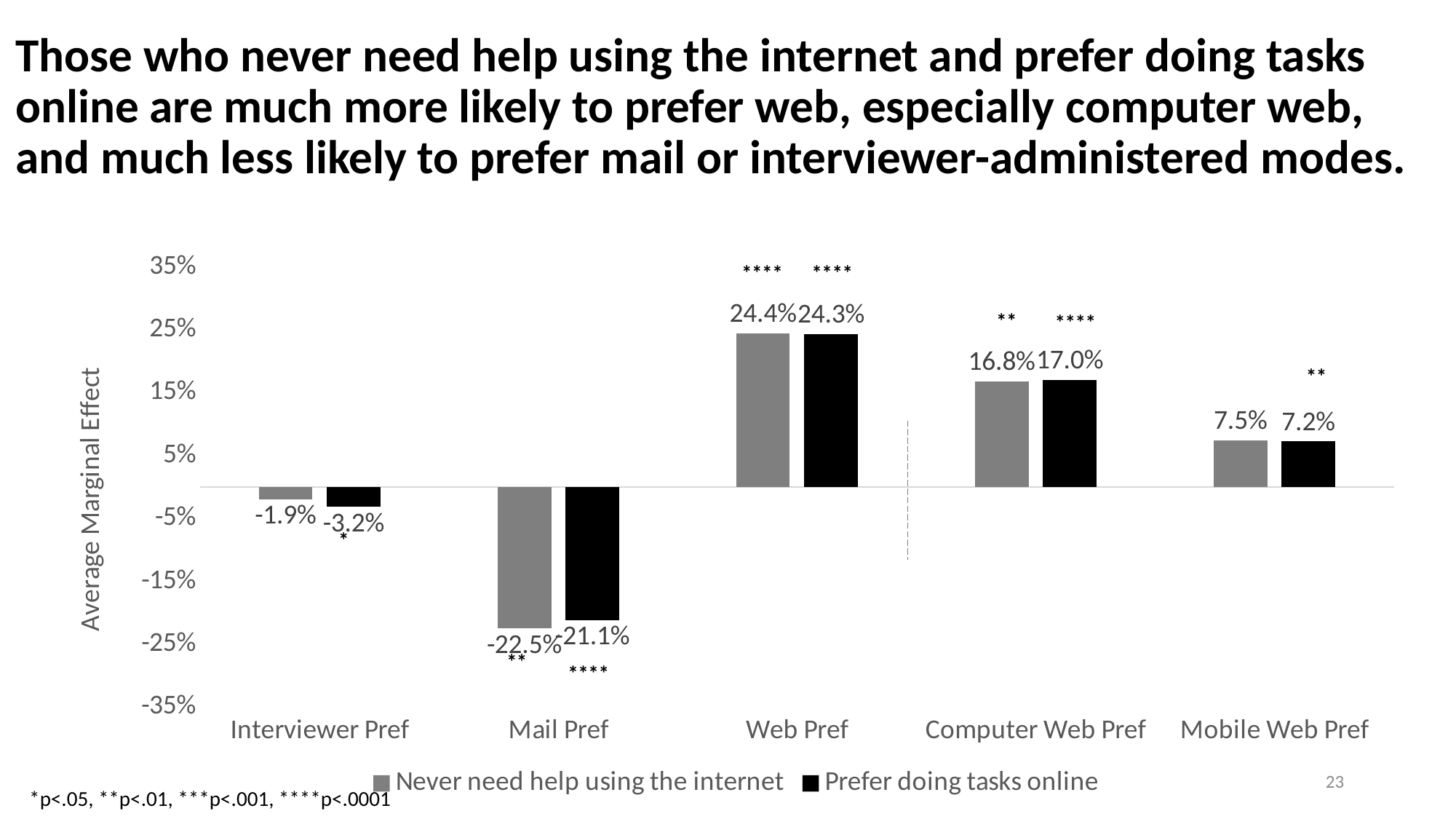
How many categories are shown on the x axis? 5 What is the value for Interviewer Pref in the 'Never need help using the internet' series? -1.9% Which category has the highest value in the 'Never need help using the internet' series? Web Pref Which category has the lowest value in the 'Prefer doing tasks online' series? Mail Pref What is the title of the vertical axis? Average Marginal Effect What is the difference between the two series' values for Mobile Web Pref? 0.3 percentage points What is the value for Mobile Web Pref in the 'Prefer doing tasks online' series? 7.2% How many series does the legend list? 2 What is the value for Computer Web Pref in the 'Prefer doing tasks online' series? 17.0% For Interviewer Pref, which series has the larger value: 'Never need help using the internet' or 'Prefer doing tasks online'? Never need help using the internet What is the value for Web Pref in the 'Never need help using the internet' series? 24.4% Is the value for Mail Pref in the 'Prefer doing tasks online' series greater or less than -15%? less